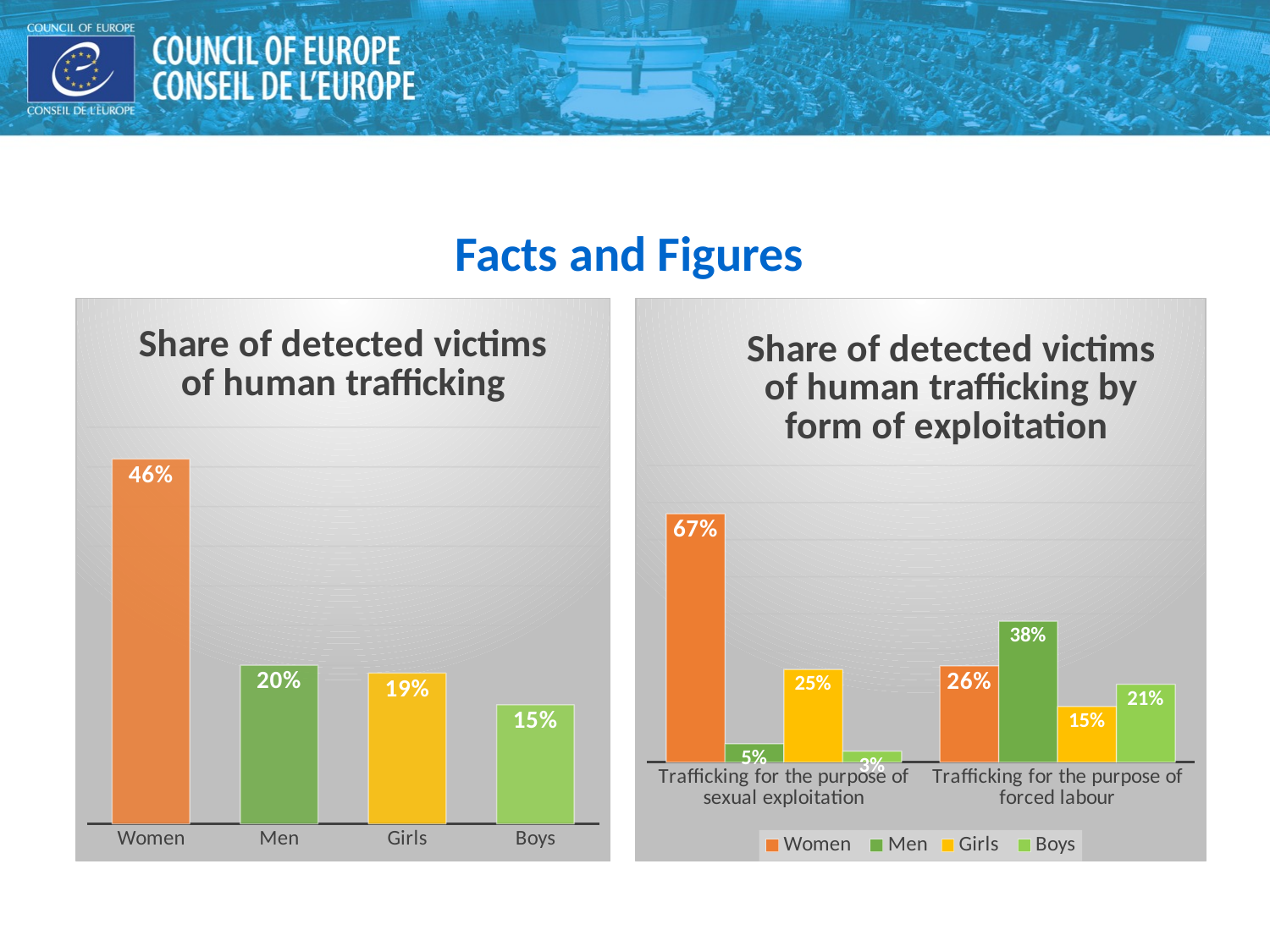
In the chart titled 'Share of detected victims of human trafficking by form of exploitation', is the value for Women higher under sexual exploitation or forced labour? Sexual exploitation In the chart titled 'Share of detected victims of human trafficking', what is the difference between the values for Women and Men? 26% In the chart titled 'Share of detected victims of human trafficking by form of exploitation', what is the value for Girls under trafficking for the purpose of sexual exploitation? 25% In the chart titled 'Share of detected victims of human trafficking', how many categories are shown? 4 In the chart titled 'Share of detected victims of human trafficking by form of exploitation', what colour represents the Boys series? Light green In the chart titled 'Share of detected victims of human trafficking by form of exploitation', what is the difference between the Women values for sexual exploitation and forced labour? 41% In the chart titled 'Share of detected victims of human trafficking by form of exploitation', what is the value for Men under trafficking for the purpose of forced labour? 38% In the chart titled 'Share of detected victims of human trafficking', what kind of chart is it? Bar chart In the chart titled 'Share of detected victims of human trafficking by form of exploitation', which series has the highest value under trafficking for the purpose of sexual exploitation? Women In the chart titled 'Share of detected victims of human trafficking by form of exploitation', how many series does the legend list? 4 In the chart titled 'Share of detected victims of human trafficking', which category has the lowest value? Boys In the chart titled 'Share of detected victims of human trafficking', what is the value for Women? 46%